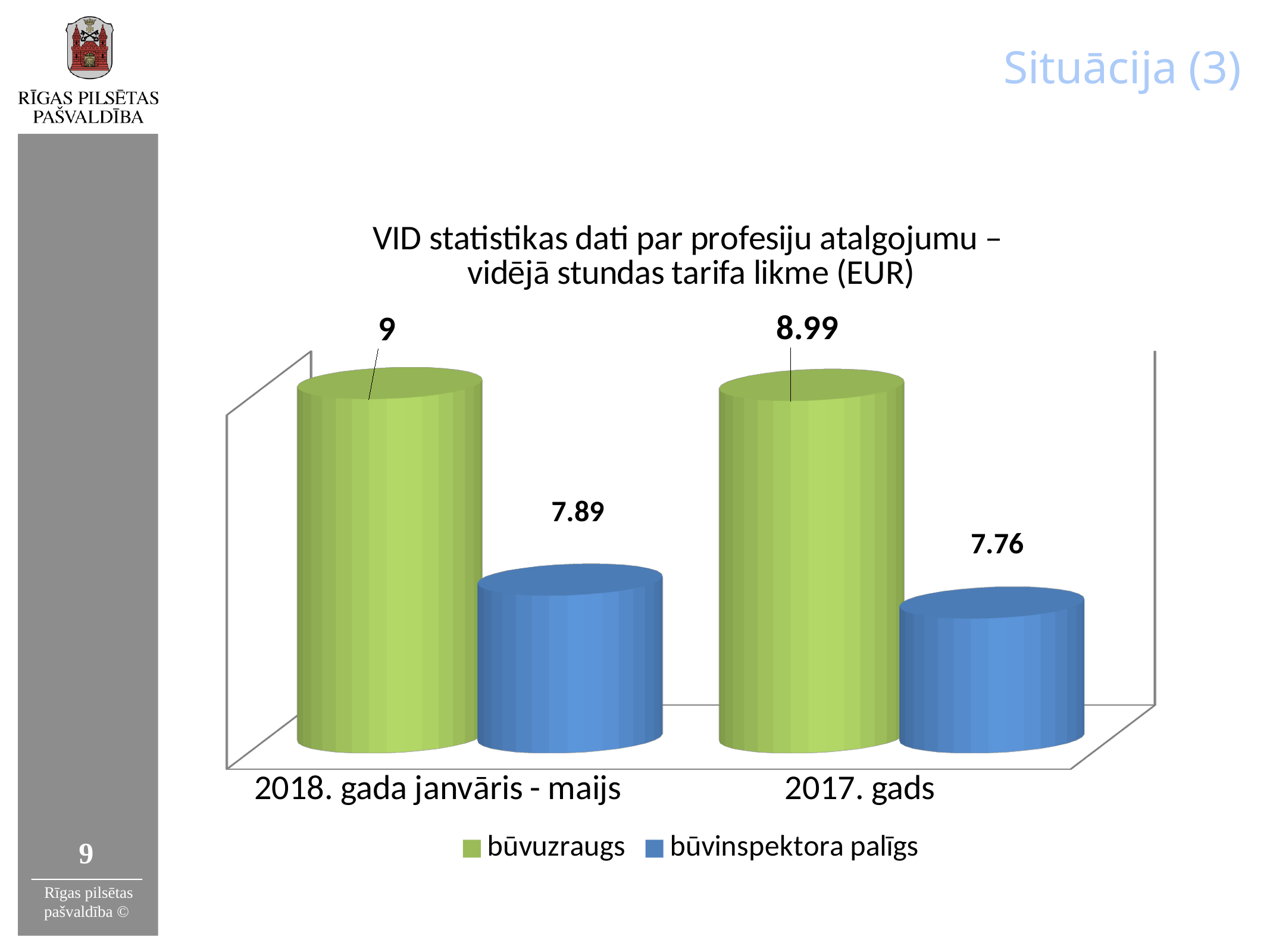
What is the value for būvuzraugs in 2017. gads? 8.99 What is the value for būvuzraugs in 2018. gada janvāris - maijs? 9 What is the difference between būvuzraugs and būvinspektora palīgs in 2017. gads? 1.23 What is the value for būvinspektora palīgs in 2018. gada janvāris - maijs? 7.89 Which is larger: būvinspektora palīgs in 2018. gada janvāris - maijs or in 2017. gads? 2018. gada janvāris - maijs What is the value for būvinspektora palīgs in 2017. gads? 7.76 How many categories are shown on the x axis? 2 What colour represents būvinspektora palīgs in the chart? blue What kind of chart is shown on the slide? bar chart Which series has the lowest value in 2017. gads? būvinspektora palīgs What is the difference between būvuzraugs and būvinspektora palīgs in 2018. gada janvāris - maijs? 1.11 How many series does the legend list? 2